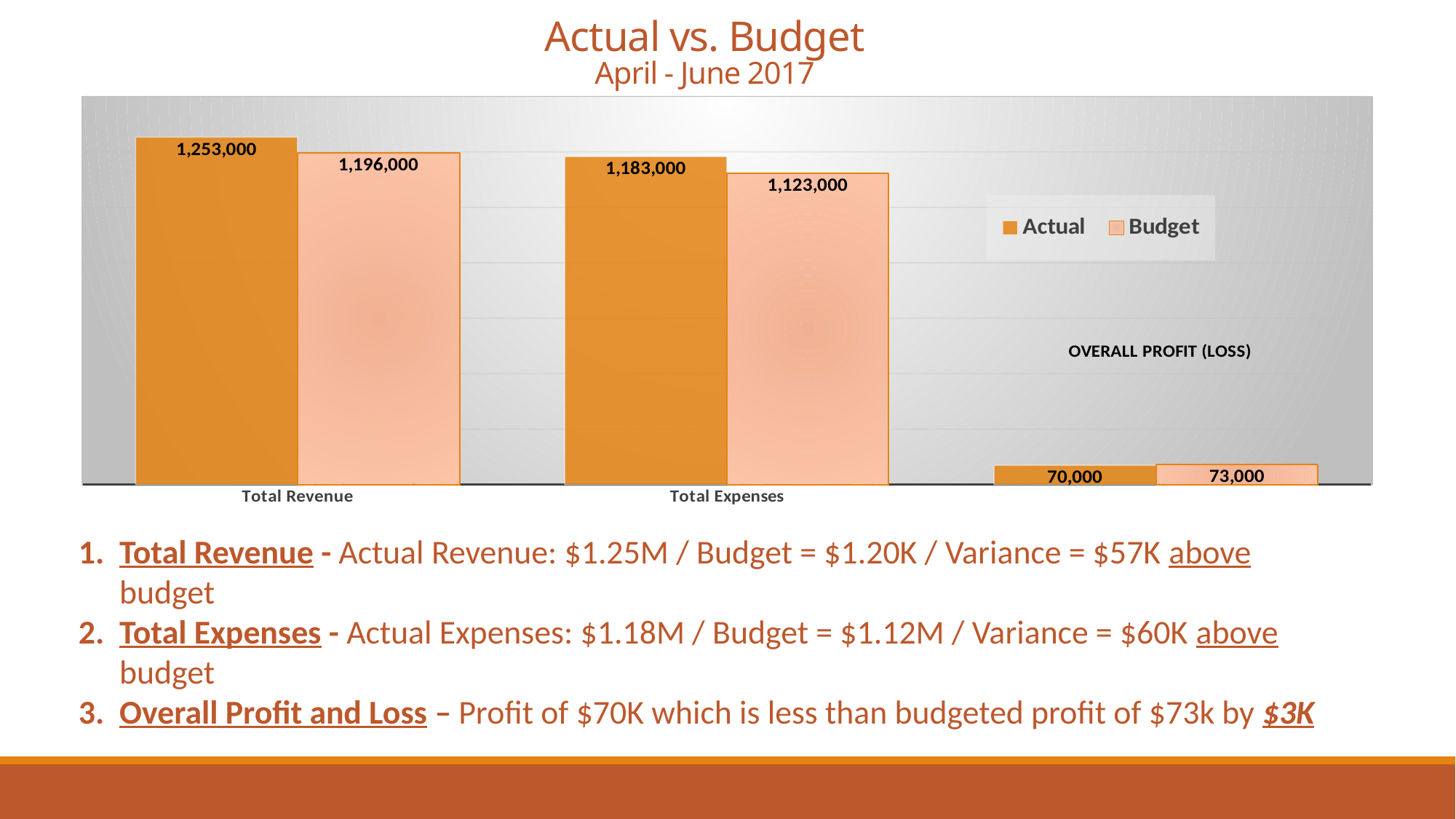
What is the Actual value for Overall Profit (Loss)? 70,000 What is the Actual value for Total Revenue? 1,253,000 What is the Budget value for Total Revenue? 1,196,000 Which category has the lowest Actual value? Overall Profit (Loss) Which is larger for Overall Profit (Loss), the Actual value or the Budget value? Budget What is the difference between the Actual and Budget values for Total Revenue? 57,000 What is the Budget value for Overall Profit (Loss)? 73,000 What is the Budget value for Total Expenses? 1,123,000 What is the Actual value for Total Expenses? 1,183,000 How many series does the legend list? 2 What kind of chart is shown on the slide? Bar chart What is the difference between the Actual and Budget values for Total Expenses? 60,000